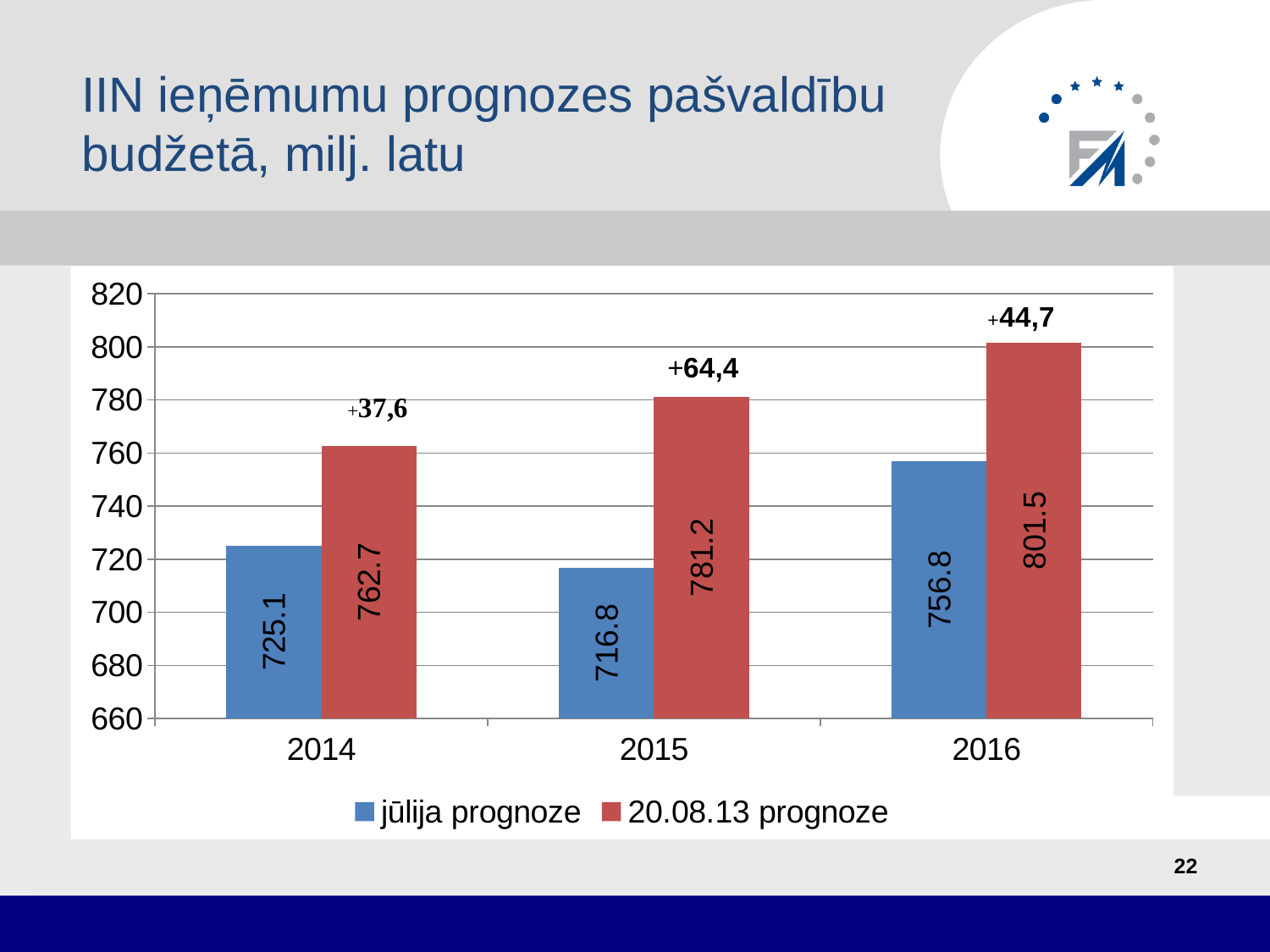
What is the difference between the 20.08.13 prognoze and the jūlija prognoze values for 2014? 37.6 What kind of chart is shown on the slide? bar chart Is the value of the 20.08.13 prognoze series for 2016 greater or less than 800? greater Which year has the lowest value for the jūlija prognoze series? 2015 What is the value of the jūlija prognoze series for 2014? 725.1 Which year has the highest value for the jūlija prognoze series? 2016 Does the 20.08.13 prognoze series rise or fall from 2014 to 2016? rise Which is larger for 2015: the jūlija prognoze value or the 20.08.13 prognoze value? 20.08.13 prognoze What is the value of the 20.08.13 prognoze series for 2016? 801.5 How many years are shown on the x axis? 3 What is the value of the 20.08.13 prognoze series for 2015? 781.2 How many series does the legend list? 2